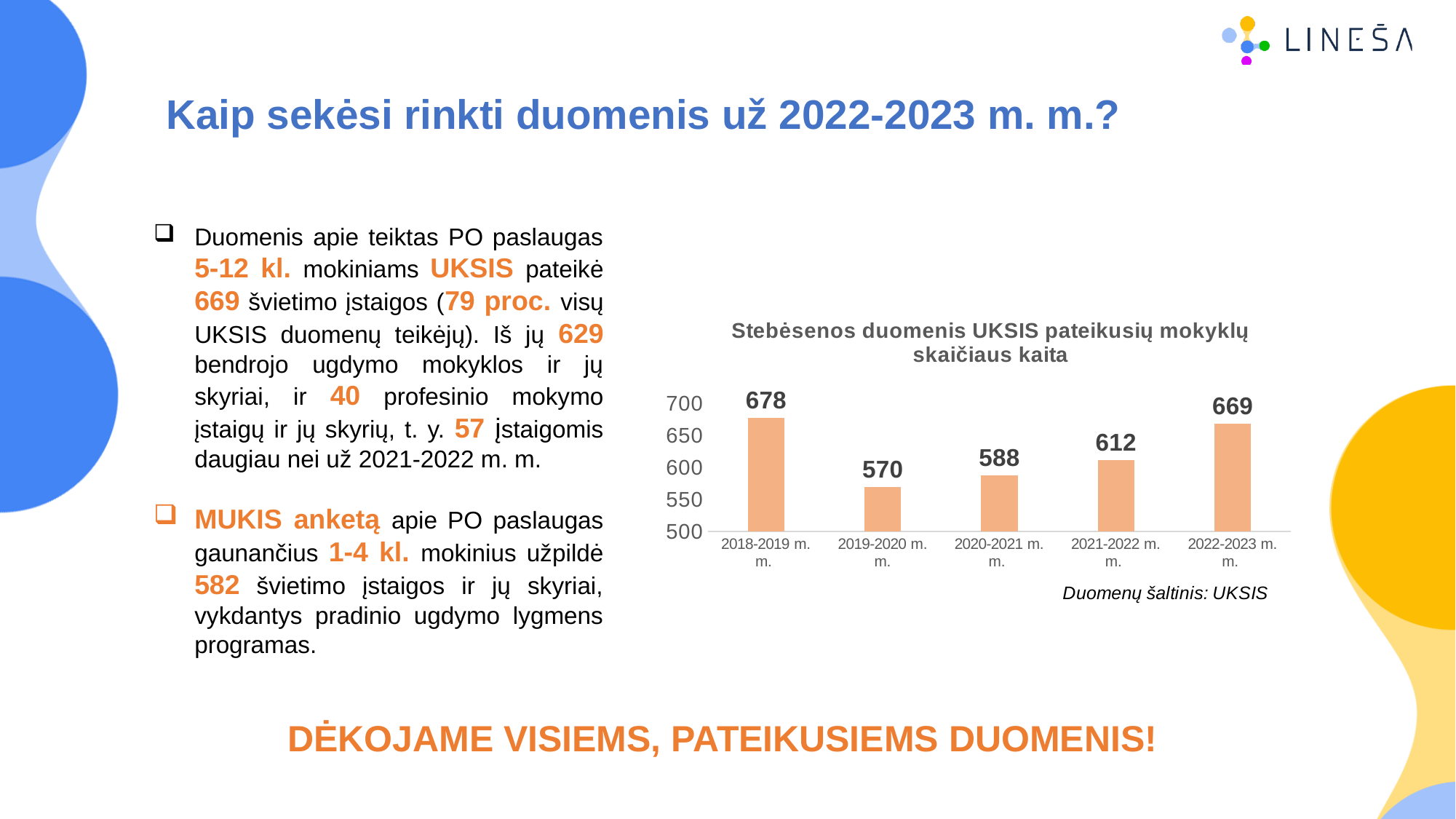
What kind of chart is shown on the slide? bar chart What is the value for 2022-2023 m. m.? 669 Which school year has the highest value? 2018-2019 m. m. What is the title of the chart? Stebėsenos duomenis UKSIS pateikusių mokyklų skaičiaus kaita Is the value for 2020-2021 m. m. greater or less than 600? less What is the value for 2018-2019 m. m.? 678 How many school years are shown on the x axis? 5 What is the difference between the values for 2022-2023 m. m. and 2021-2022 m. m.? 57 What is the value for 2019-2020 m. m.? 570 Which school year has the lowest value? 2019-2020 m. m. Do the values rise or fall from 2019-2020 m. m. to 2022-2023 m. m.? rise Which is larger, the value for 2020-2021 m. m. or 2021-2022 m. m.? 2021-2022 m. m.